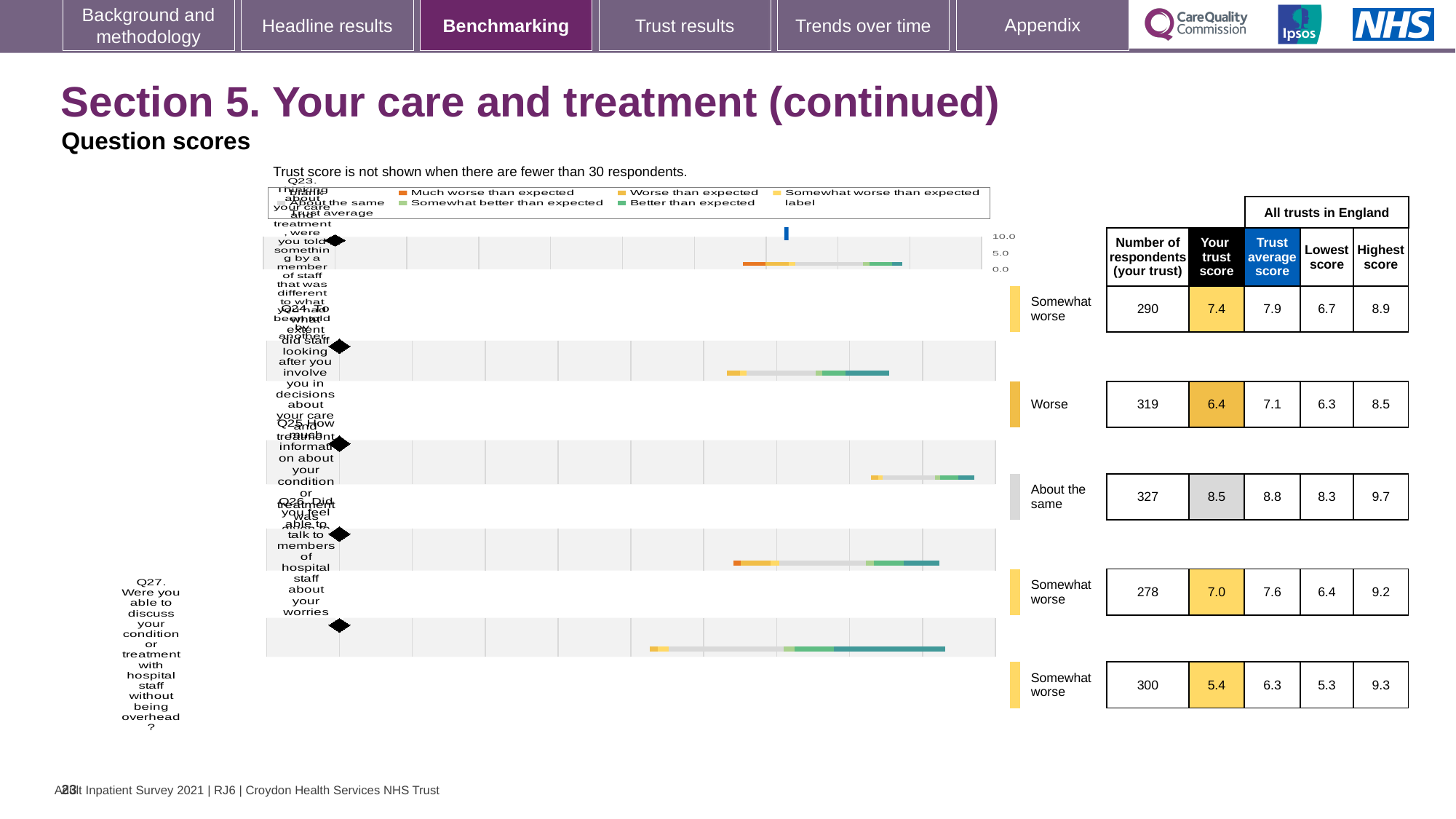
What is the highest score among all trusts in England for Q27 (the last row)? 9.3 For Q26 (the fourth row), which is larger: the trust's own score or the trust average score? Trust average score What kind of chart is used to show the question scores on this slide? bar chart What benchmark category is shown for Q24 (the second row)? Worse How many respondents are shown for Q25 (the third row)? 327 Which question has the highest trust score on this slide? Q25 For Q23 (the first row), what is the difference between the trust average score and this trust's score? 0.5 What is the trust score for Q24 (the second row of the chart)? 6.4 How many questions (Q23 to Q27) are plotted in the benchmarking chart? 5 Is the trust score for Q27 (the last row) greater or less than 5.0? greater What is the maximum value shown on the chart's score axis? 10.0 Which question has the lowest trust score on this slide? Q27